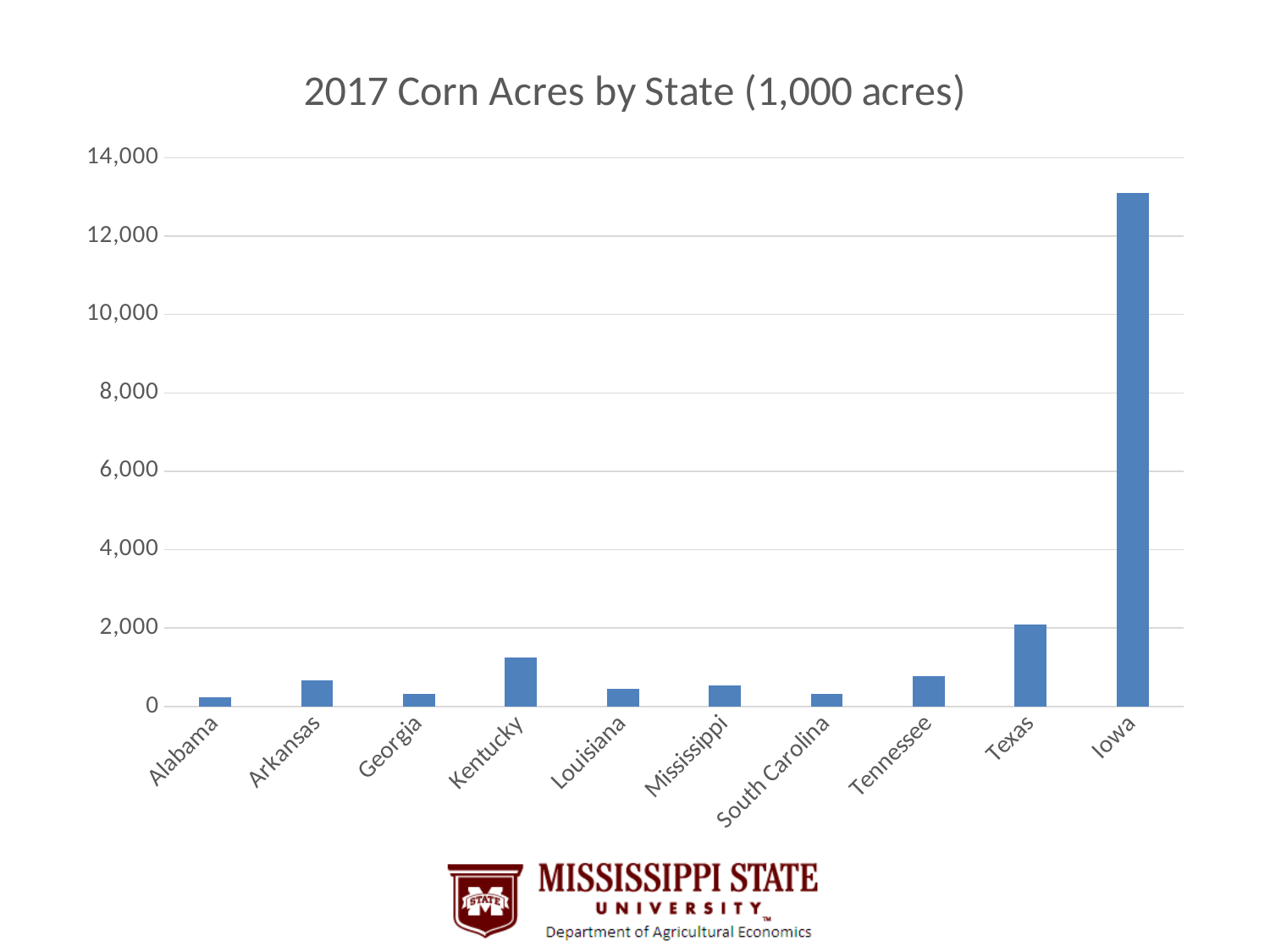
Which has the larger value, Kentucky or Tennessee? Kentucky Which has the larger value, Texas or Kentucky? Texas Is the value for Kentucky greater or less than 2,000? less Which state has the lowest corn acreage in the chart? Alabama Which state has the highest corn acreage in the chart? Iowa Which has the larger value, Arkansas or Louisiana? Arkansas Is the value for Texas greater or less than 4,000? less What kind of chart is shown on the slide? bar chart Is the value for Iowa greater or less than 12,000? greater What is the title of the chart? 2017 Corn Acres by State (1,000 acres) How many states are shown on the x axis of the chart? 10